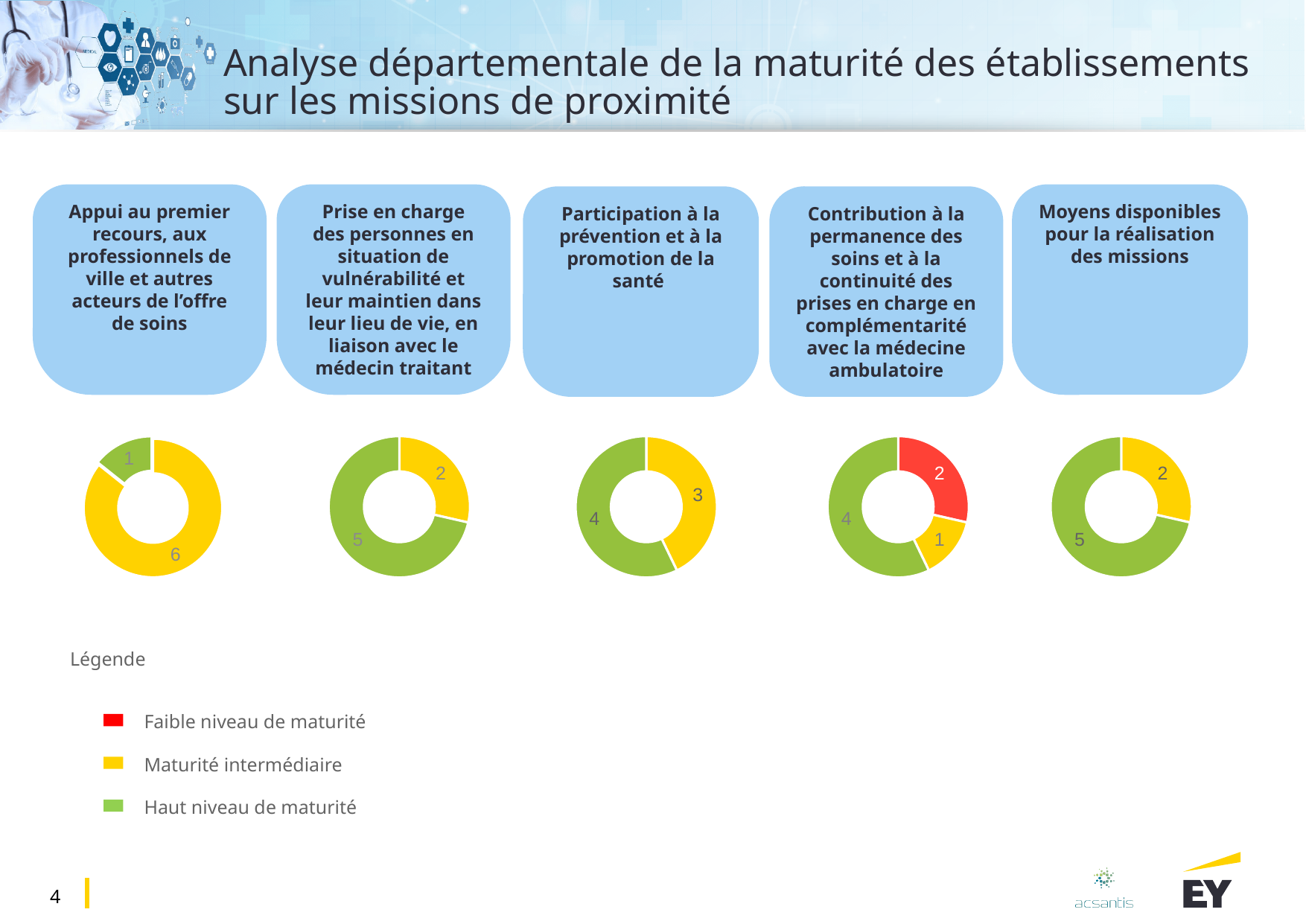
In the fourth donut chart (Contribution à la permanence des soins), which maturity level has the smallest segment? Maturité intermédiaire In the first donut chart from the left (Appui au premier recours), how many establishments have a high level of maturity (green)? 1 How many donut charts are shown on the slide? 5 In the second donut chart (Prise en charge des personnes en situation de vulnérabilité), what is the value of the green segment? 5 In the first donut chart from the left (Appui au premier recours), how many establishments have an intermediate level of maturity (yellow)? 6 According to the legend, what does the green colour represent? Haut niveau de maturité In the third donut chart (Participation à la prévention), what is the difference between the green and yellow segments? 1 Which of the five donut charts contains a red segment? Contribution à la permanence des soins et à la continuité des prises en charge en complémentarité avec la médecine ambulatoire In the second donut chart (Prise en charge des personnes en situation de vulnérabilité), which segment is larger, green or yellow? green In the fourth donut chart (Contribution à la permanence des soins), how many establishments have a low level of maturity (red)? 2 In the fifth donut chart (Moyens disponibles pour la réalisation des missions), what is the total of all segments? 7 In the third donut chart (Participation à la prévention et à la promotion de la santé), what is the value of the yellow segment? 3